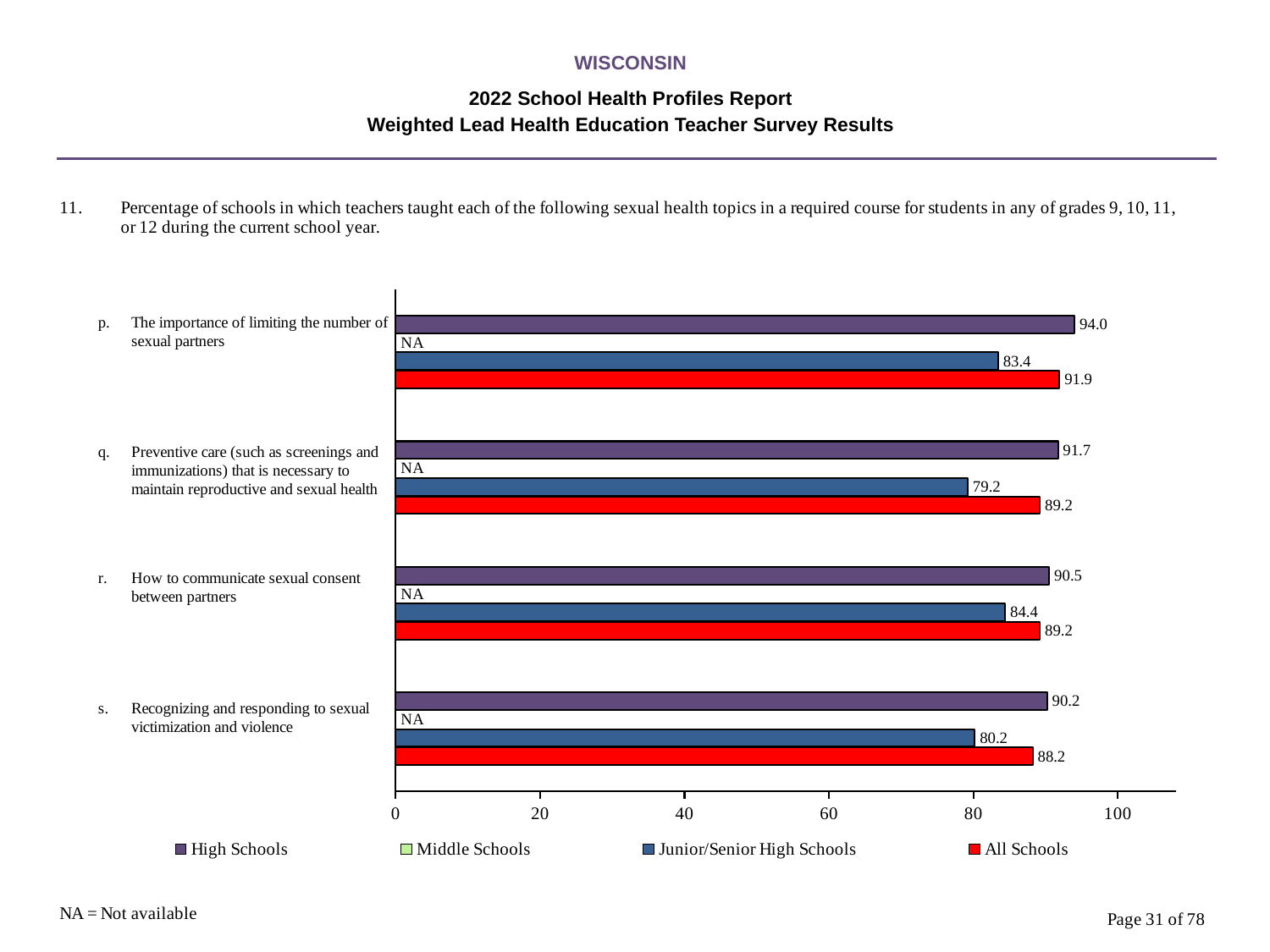
What is the High Schools value for 'The importance of limiting the number of sexual partners'? 94.0 What is the Junior/Senior High Schools value for 'Preventive care (such as screenings and immunizations) that is necessary to maintain reproductive and sexual health'? 79.2 What is the Middle Schools value for 'How to communicate sexual consent between partners'? NA How many series does the legend list? 4 What is the All Schools value for 'Recognizing and responding to sexual victimization and violence'? 88.2 Which topic has the lowest Junior/Senior High Schools value? Preventive care (such as screenings and immunizations) that is necessary to maintain reproductive and sexual health How many topics are shown on the chart? 4 Which is larger for 'How to communicate sexual consent between partners': the High Schools value or the All Schools value? High Schools Which topic has the highest High Schools value? The importance of limiting the number of sexual partners Is the Junior/Senior High Schools value for 'Recognizing and responding to sexual victimization and violence' greater or less than 80? greater What is the difference between the High Schools and Junior/Senior High Schools values for 'The importance of limiting the number of sexual partners'? 10.6 What kind of chart is shown on the slide? bar chart